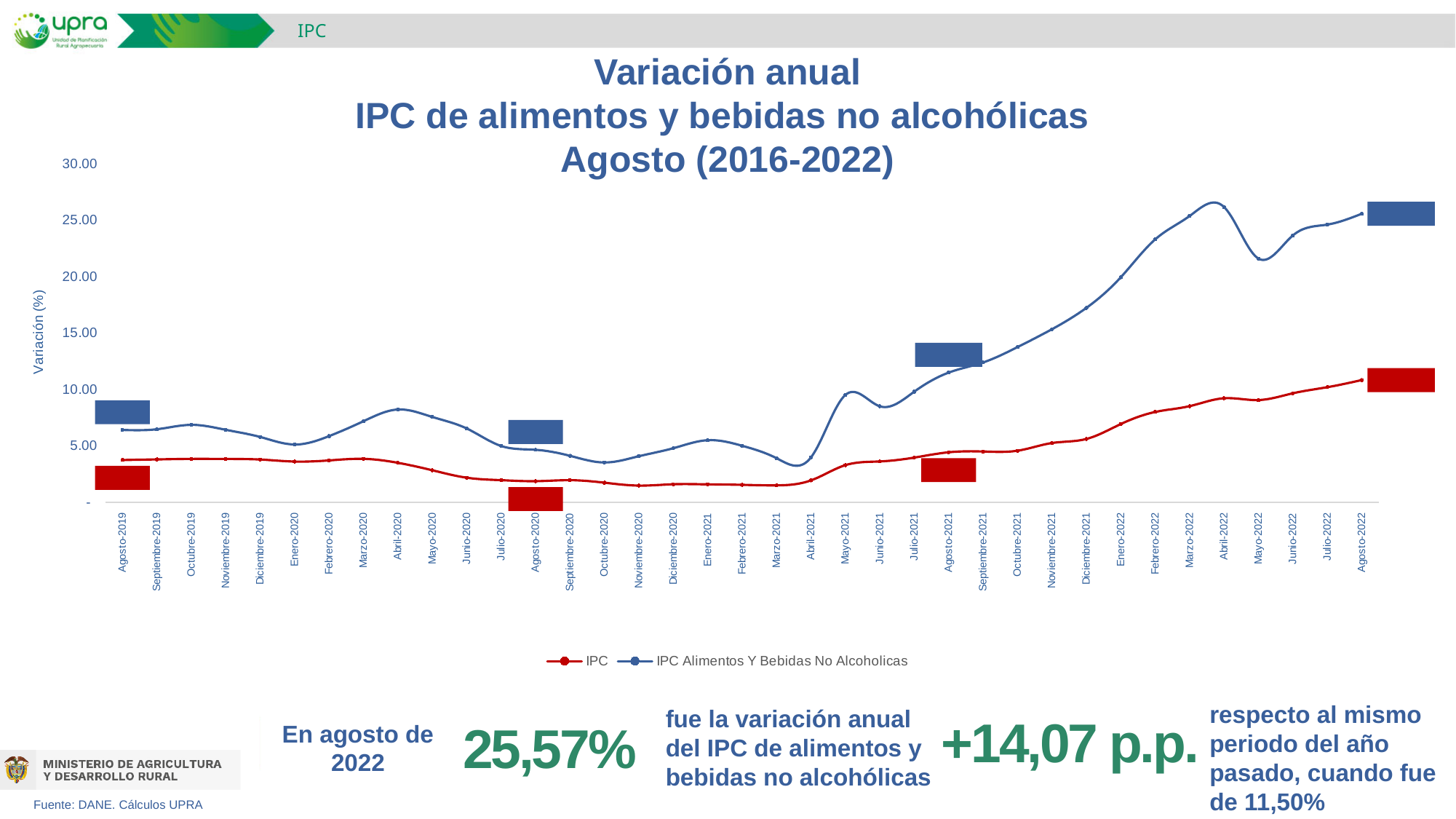
According to the slide, what was the annual variation of the IPC de alimentos y bebidas no alcohólicas in Agosto-2022? 25,57% In Agosto-2022, which series has the larger value, IPC or IPC Alimentos Y Bebidas No Alcoholicas? IPC Alimentos Y Bebidas No Alcoholicas Does the IPC Alimentos Y Bebidas No Alcoholicas series rise or fall between Marzo-2021 and Abril-2022? rise How many series does the legend list? 2 According to the slide, what was the annual variation of the IPC de alimentos y bebidas no alcohólicas in Agosto-2021? 11,50% How many monthly points are plotted along the x axis, from Agosto-2019 to Agosto-2022? 37 Is the value of the IPC Alimentos Y Bebidas No Alcoholicas series for Octubre-2020 greater or less than 5.00? less What kind of chart is shown on the slide? line chart By how many percentage points did the annual variation of the IPC de alimentos y bebidas no alcohólicas change between Agosto-2021 and Agosto-2022? +14,07 p.p. In which month does the IPC Alimentos Y Bebidas No Alcoholicas series reach its highest value? Abril-2022 Is the value of the IPC series for Agosto-2022 greater or less than 10.00? greater In which month does the IPC Alimentos Y Bebidas No Alcoholicas series reach its lowest value? Octubre-2020